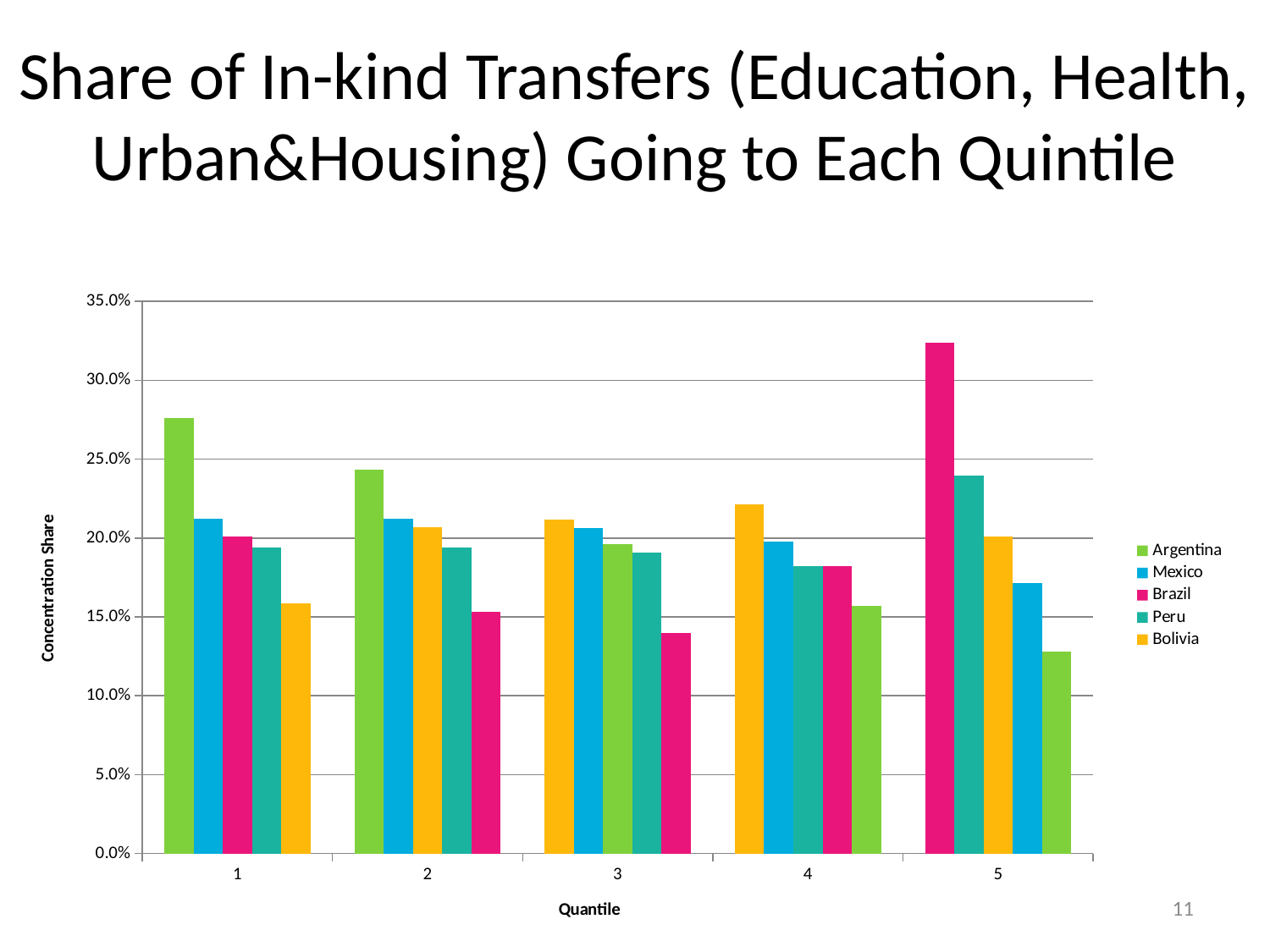
What is the label on the vertical axis? Concentration Share What kind of chart is shown on the slide? bar chart How many quintile categories are shown on the x axis? 5 Does Argentina's concentration share rise or fall from quintile 1 to quintile 5? fall Which country has the lowest concentration share in quintile 5? Argentina Is the value for Brazil in quintile 5 greater or less than 30.0%? greater Which country has the lowest concentration share in quintile 3? Brazil Which country has the highest concentration share in quintile 1? Argentina Which country has the highest concentration share in quintile 5? Brazil How many series does the legend list? 5 Is the value for Bolivia in quintile 1 greater or less than 20.0%? less In quintile 1, which is larger: the value for Argentina or the value for Bolivia? Argentina